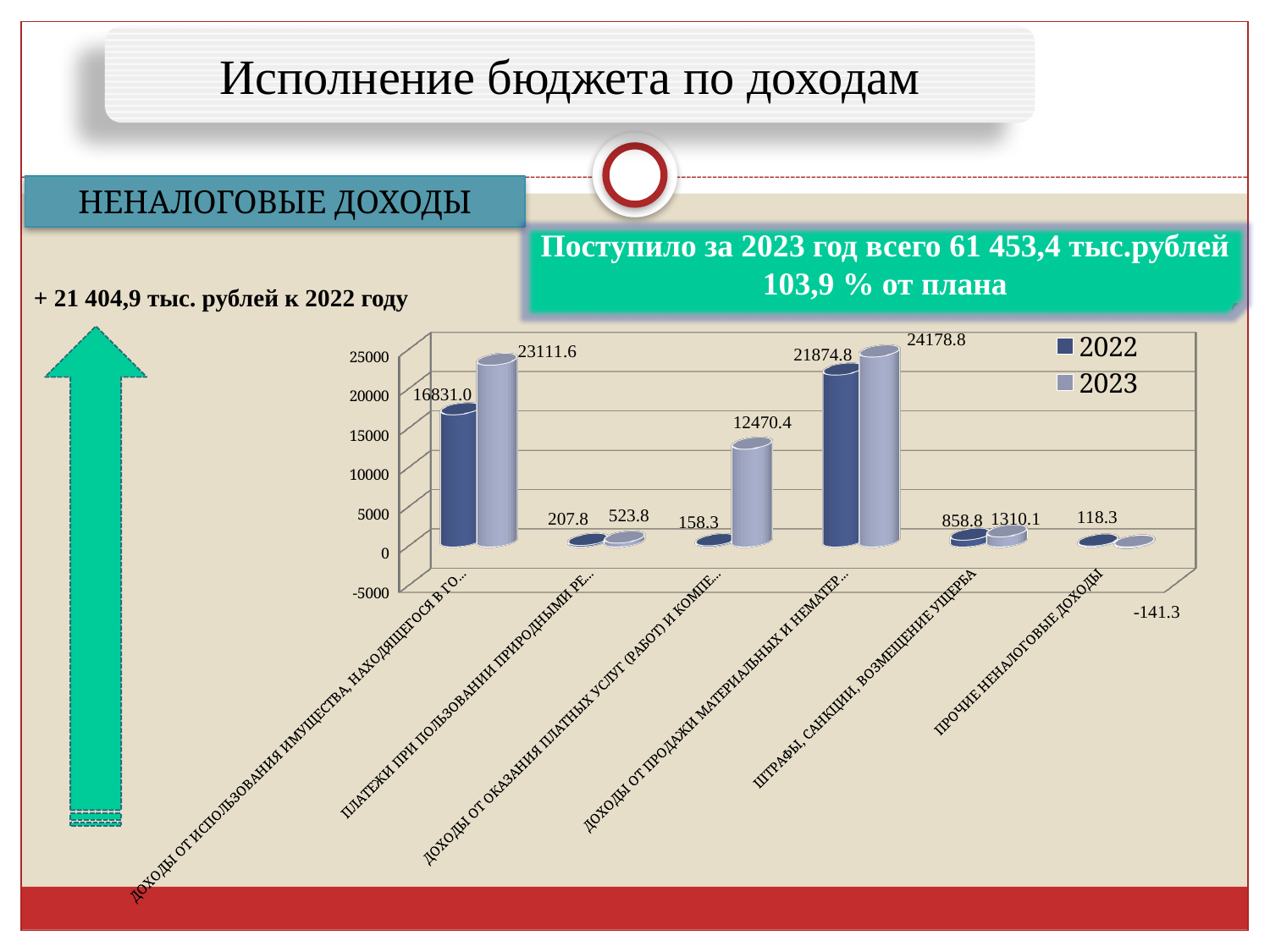
Which is larger in 2022: "Штрафы, санкции, возмещение ущерба" or "Платежи при пользовании природными ре..."? Штрафы, санкции, возмещение ущерба By how much did the value for "Штрафы, санкции, возмещение ущерба" increase from 2022 to 2023? 451.3 What is the difference between the 2023 and 2022 values for "Доходы от продажи материальных и нематер..."? 2304.0 How many series does the chart legend list? 2 What is the 2022 value for "Прочие неналоговые доходы"? 118.3 What is the 2023 value for "Штрафы, санкции, возмещение ущерба"? 1310.1 How many categories are shown on the x axis of the chart? 6 Which category has the lowest 2023 value? Прочие неналоговые доходы Which category has the highest 2023 value? Доходы от продажи материальных и нематер... What type of chart is shown on the slide? Bar chart What is the 2023 value for "Прочие неналоговые доходы"? -141.3 What is the 2023 value for the category "Доходы от оказания платных услуг (работ) и компе..."? 12470.4